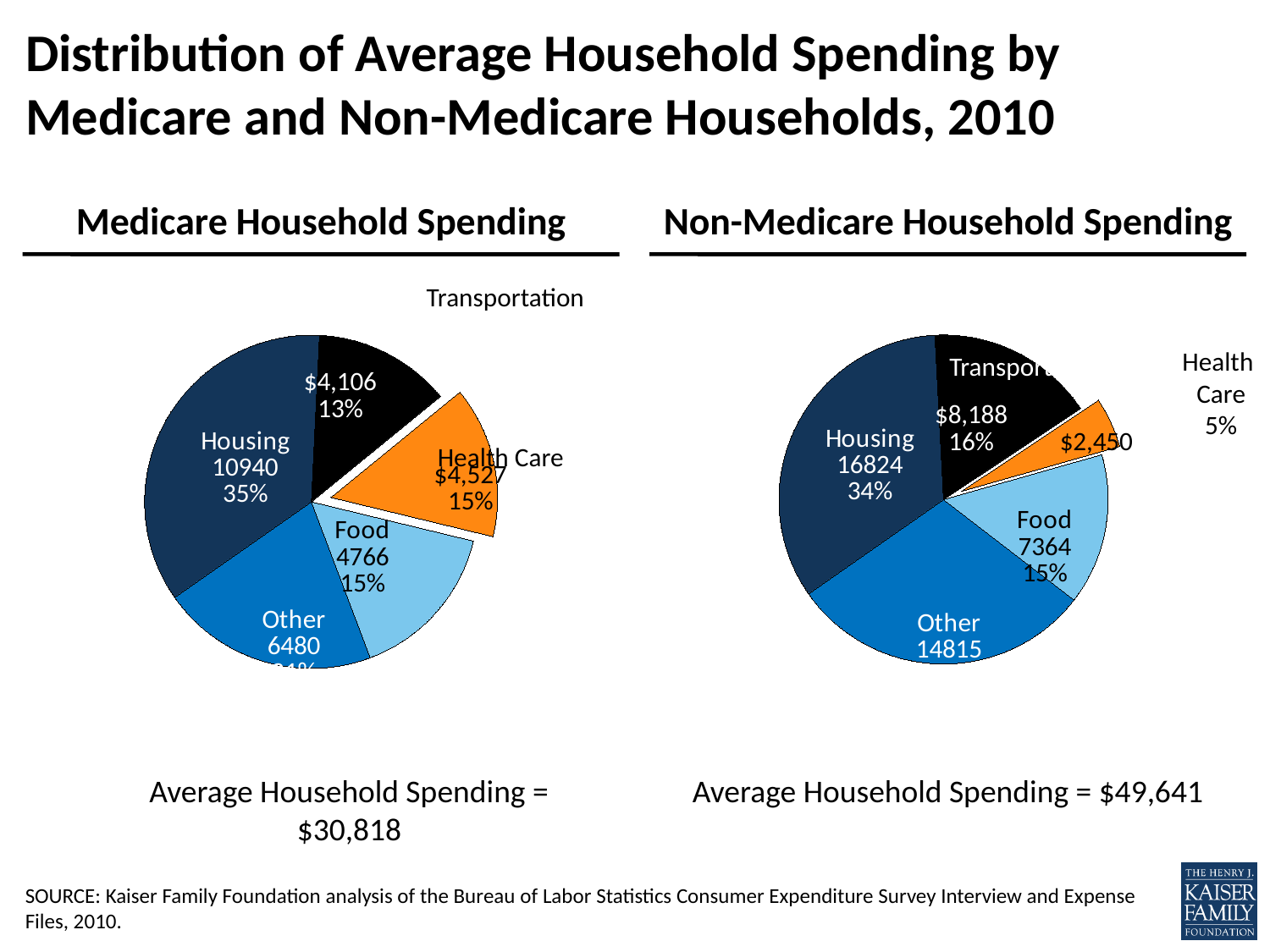
How many categories does the Non-Medicare Household Spending chart show? 5 In the Medicare Household Spending chart, what is the value for Transportation? $4,106 In the Non-Medicare Household Spending chart, what share of spending is Transportation? 16% In the Medicare Household Spending chart, what share of spending is Health Care? 15% What is the average household spending shown under the Medicare Household Spending chart? $30,818 What kind of chart is used for Medicare Household Spending? Pie chart In the Non-Medicare Household Spending chart, what is the value for Health Care? $2,450 In the Non-Medicare Household Spending chart, which category is the largest? Housing In the Non-Medicare Household Spending chart, which category is the smallest? Health Care In the Non-Medicare Household Spending chart, what is the difference between Housing and Other? 2009 In the Medicare Household Spending chart, which is larger, Other or Food? Other In the Medicare Household Spending chart, what is the value for Housing? 10940